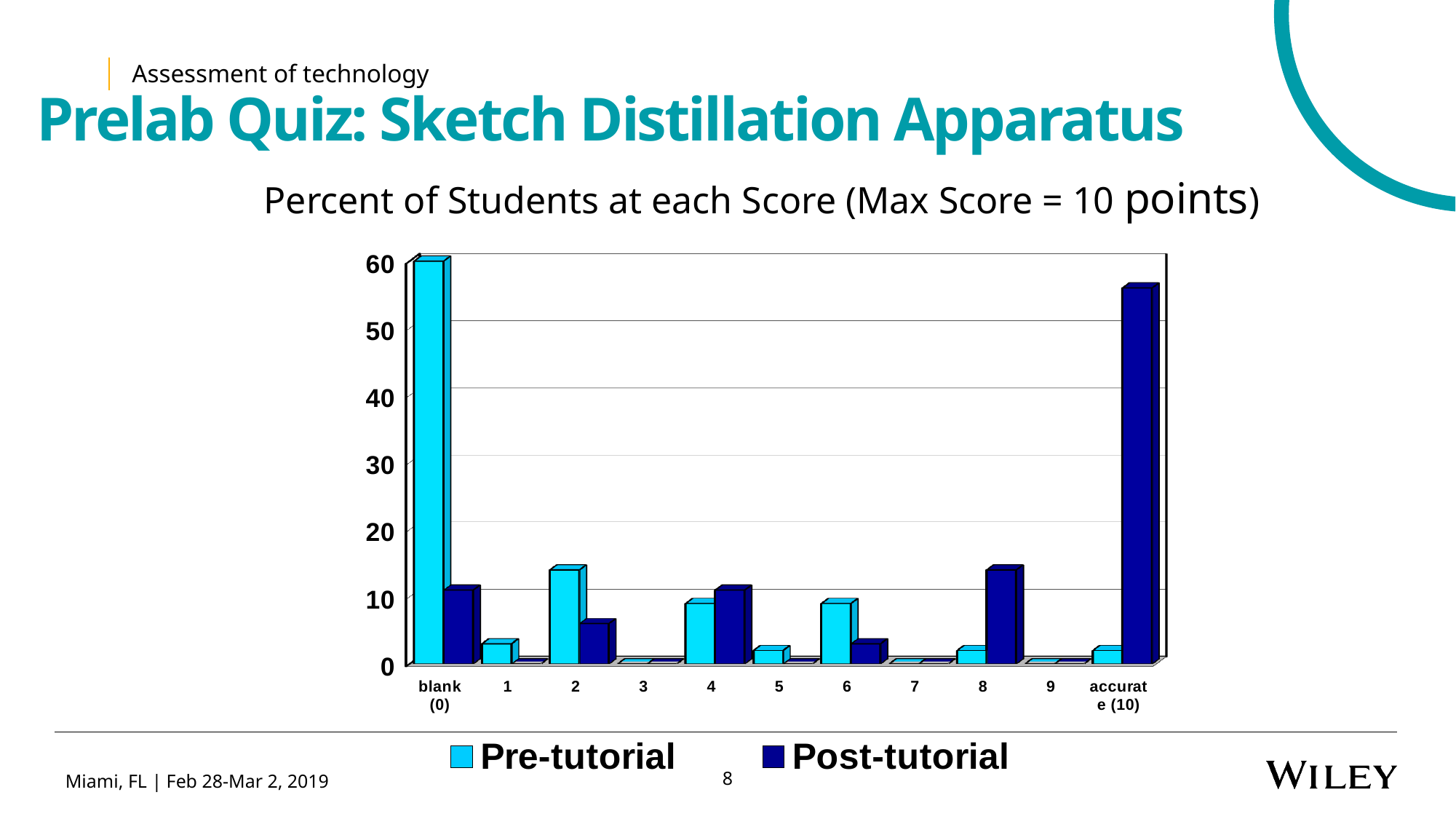
Is the Post-tutorial value for score 2 greater or less than 10? less Which series is shown in dark blue in the legend? Post-tutorial How many series does the legend list? 2 Which score category has the highest Post-tutorial value? accurate (10) Which score category has the highest Pre-tutorial value? blank (0) For the blank (0) category, which is larger: the Pre-tutorial or the Post-tutorial value? Pre-tutorial Is the Post-tutorial value for accurate (10) greater or less than 50? greater How many score categories are shown along the x axis? 11 What kind of chart is shown on the slide? bar chart Is the Post-tutorial value for score 8 greater or less than 10? greater For the accurate (10) category, which is larger: the Pre-tutorial or the Post-tutorial value? Post-tutorial